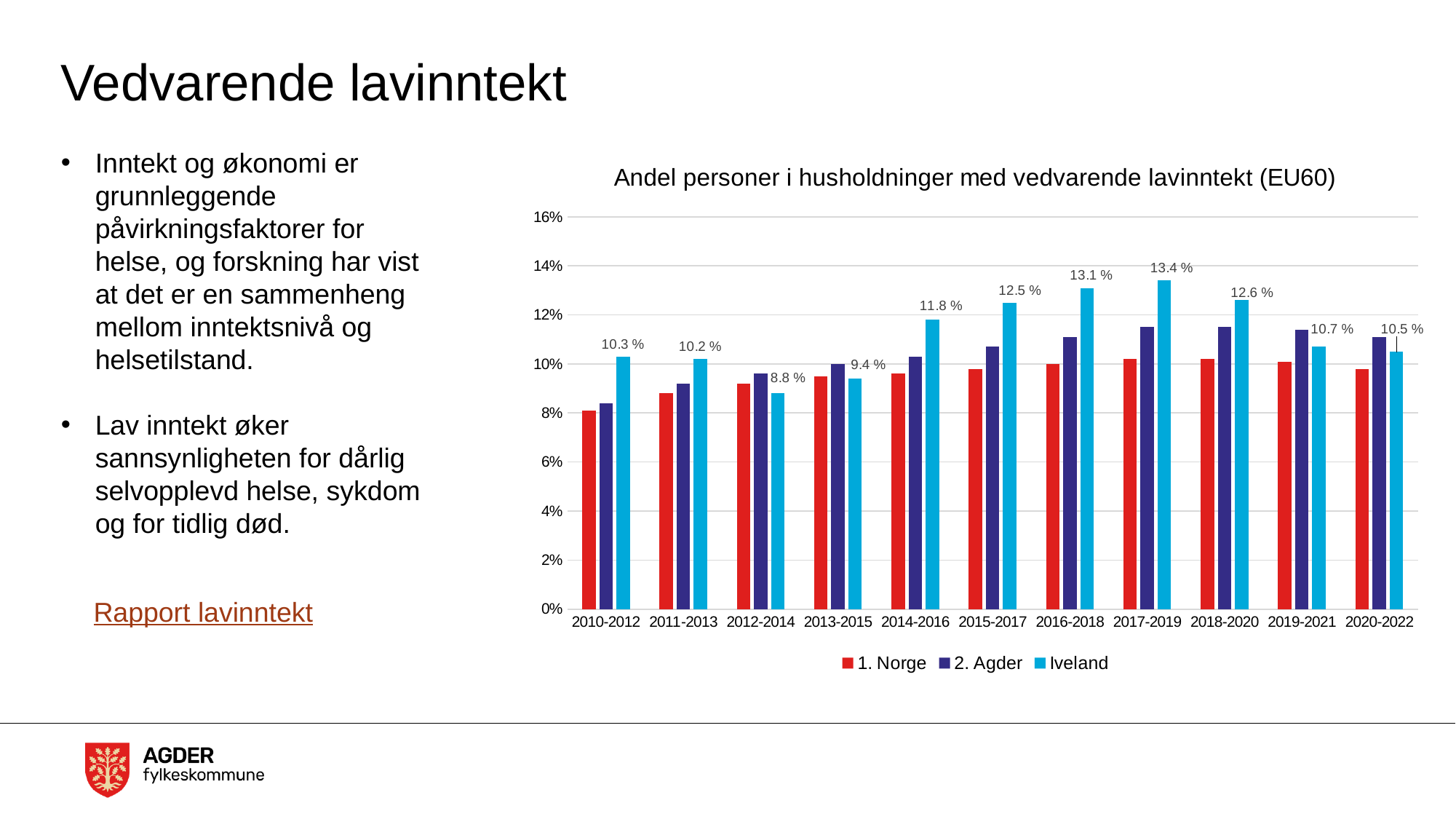
In which period is the Iveland value highest? 2017-2019 Which period has the larger Iveland value, 2014-2016 or 2015-2017? 2015-2017 What is the value for Iveland in 2017-2019? 13.4 % What is the difference between the Iveland values for 2017-2019 and 2012-2014? 4.6 percentage points Do the Iveland values rise or fall from 2017-2019 to 2020-2022? Fall What kind of chart is shown on the slide? Bar chart Is the value for 2. Agder in 2017-2019 greater or less than 12%? less Is the value for 1. Norge in 2010-2012 greater or less than 10%? less What is the value for Iveland in 2012-2014? 8.8 % In which period is the Iveland value lowest? 2012-2014 How many series does the legend list? 3 How many periods are shown on the x axis? 11